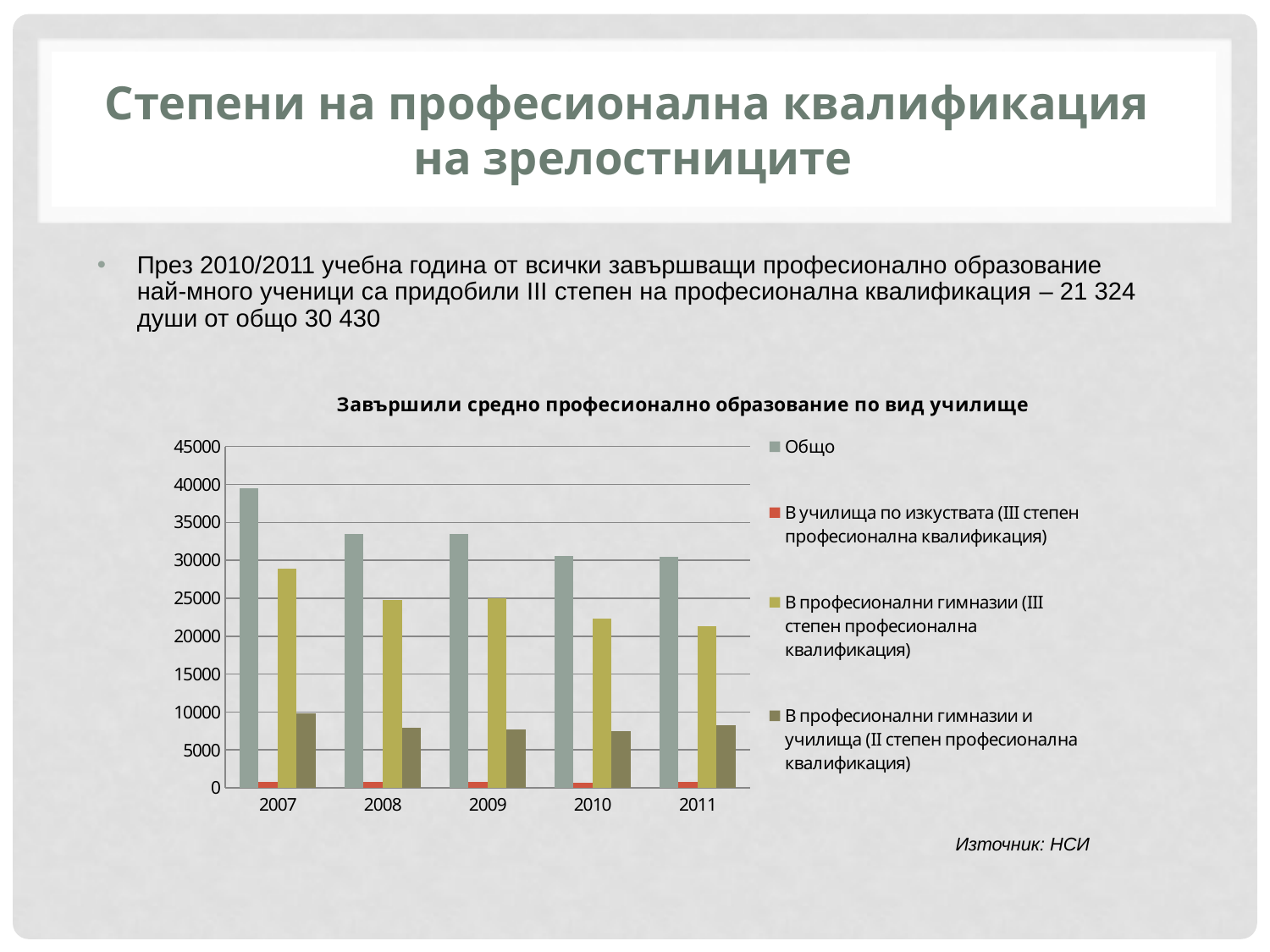
Which is larger: the value for "Общо" in 2007 or in 2011? 2007 How many series does the chart legend list? 4 Is the value for "Общо" in 2007 greater or less than 35000? greater In which year is the value for "В професионални гимназии (III степен професионална квалификация)" the highest? 2007 Is the value for "В професионални гимназии (III степен професионална квалификация)" in 2007 greater or less than 25000? greater Does the value for "Общо" rise or fall from 2007 to 2011? fall How many years are shown on the x axis of the chart? 5 Is the value for "Общо" in 2011 greater or less than 35000? less What is the title of the chart? Завършили средно професионално образование по вид училище What kind of chart is shown on the slide? bar chart In which year is the value for "Общо" the highest? 2007